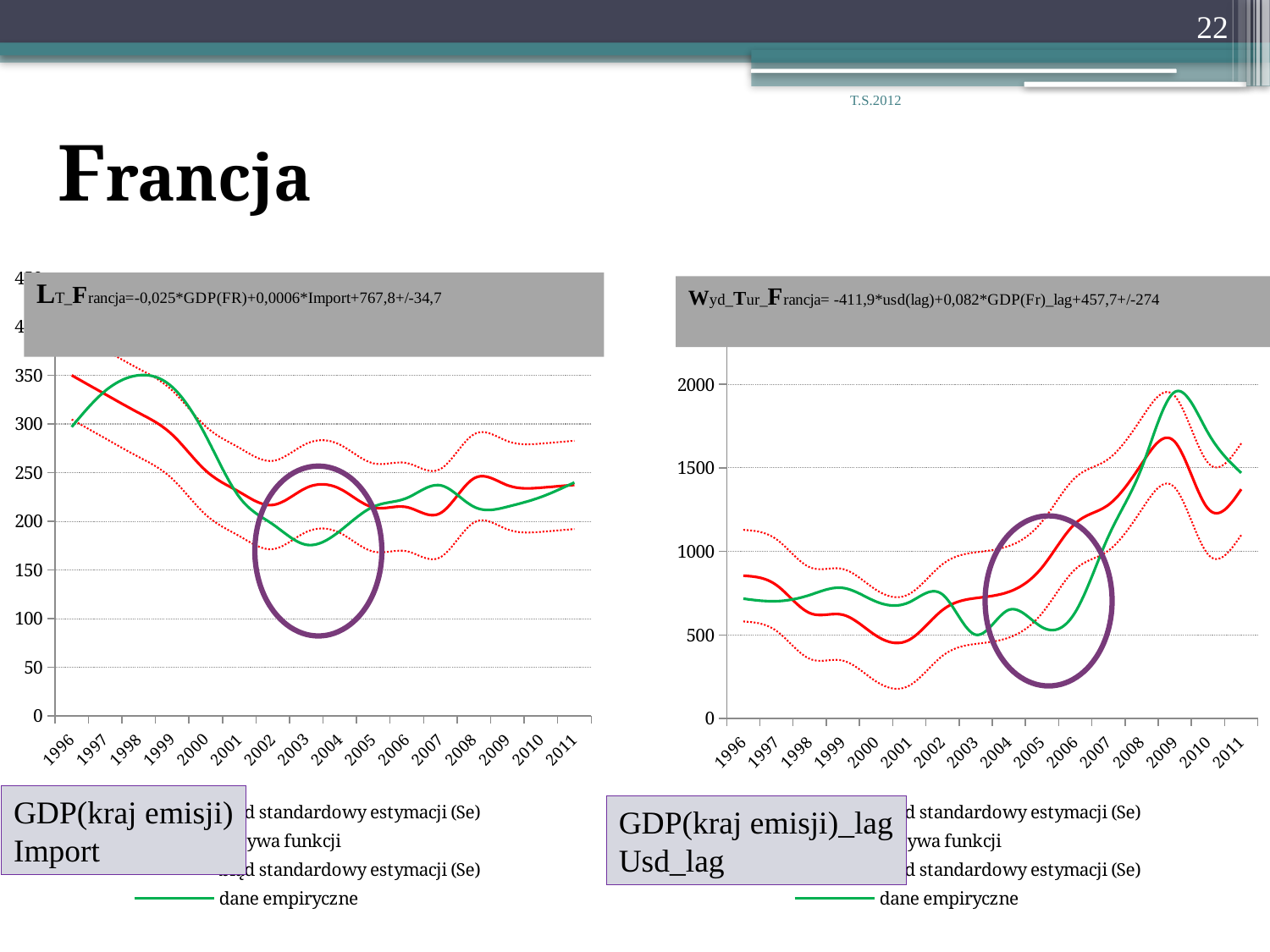
How many entries does the legend of the left chart list? 4 In the right chart, is the value of the green 'dane empiryczne' line in 2009 greater or less than 1500? greater How many years are shown on the x axis of the right chart? 16 What type of chart is the left chart on the slide? line chart In the right chart, is the value of the red 'krzywa funkcji' line in 1996 greater or less than 1000? less In the left chart, is the value of the green 'dane empiryczne' line in 1998 greater or less than 300? greater In the right chart, in which year does the green 'dane empiryczne' line reach its highest value? 2009 In the left chart, does the green 'dane empiryczne' line rise or fall between 1998 and 2003? fall In the right chart, does the green 'dane empiryczne' line rise or fall between 2005 and 2009? rise